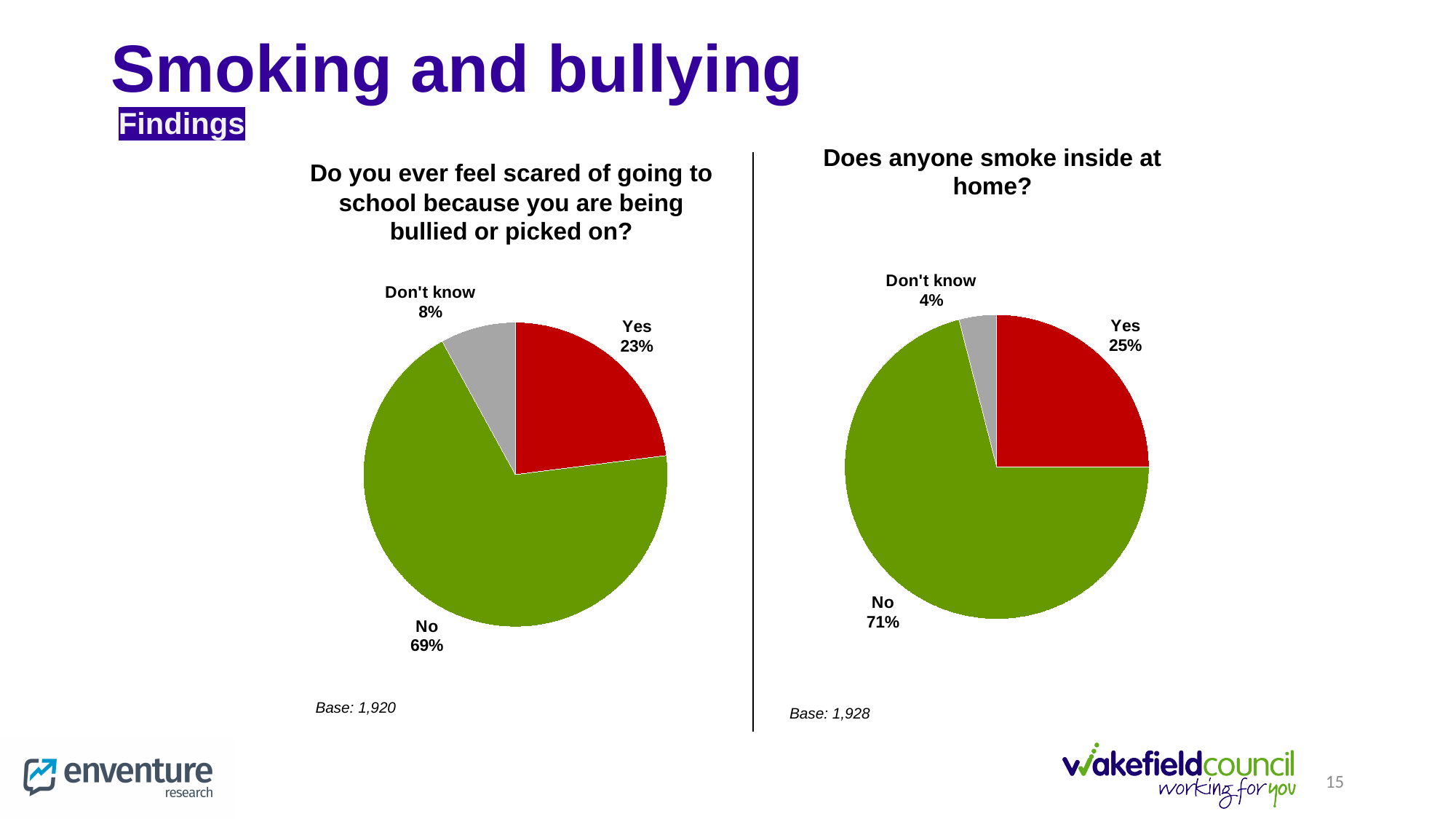
In the right pie chart about smoking inside at home, what percentage answered Don't know? 4% In the left pie chart about feeling scared of going to school, what percentage answered No? 69% What type of chart is used on this slide? Pie chart In the left pie chart about feeling scared of going to school, what percentage answered Yes? 23% In the left pie chart about feeling scared of going to school, what percentage answered Don't know? 8% In the left pie chart about feeling scared of going to school, what is the difference in percentage points between No and Yes? 46 Is the Yes share larger in the left chart about feeling scared of going to school or in the right chart about smoking inside at home? Right chart (smoking inside at home) How many slices does the right pie chart about smoking inside at home have? 3 In the right pie chart about smoking inside at home, what percentage answered Yes? 25% In the right pie chart about smoking inside at home, which response has the smallest share? Don't know In the right pie chart about smoking inside at home, what percentage answered No? 71% In the left pie chart about feeling scared of going to school, which response has the largest share? No